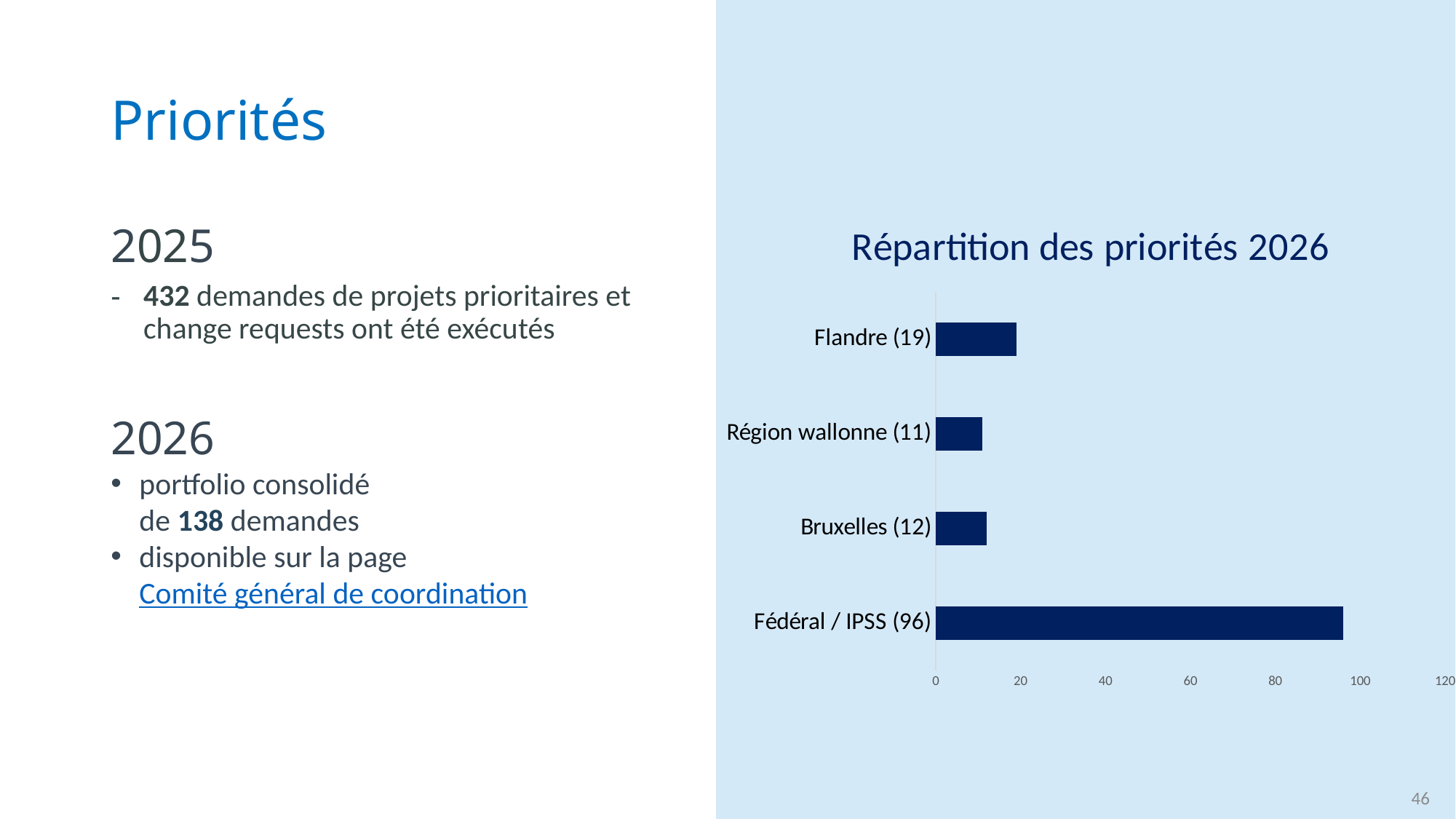
Is the value for Fédéral / IPSS greater or less than 80? greater What is the difference between the values for Fédéral / IPSS and Flandre? 77 What is the value for Flandre? 19 What is the value for Bruxelles? 12 Which is larger, the value for Flandre or the value for Bruxelles? Flandre Which category has the lowest value? Région wallonne What is the title of the chart? Répartition des priorités 2026 How many categories does the chart show? 4 What is the value for Région wallonne? 11 Which category has the highest value? Fédéral / IPSS What type of chart is shown on the slide? bar chart What is the value for Fédéral / IPSS? 96